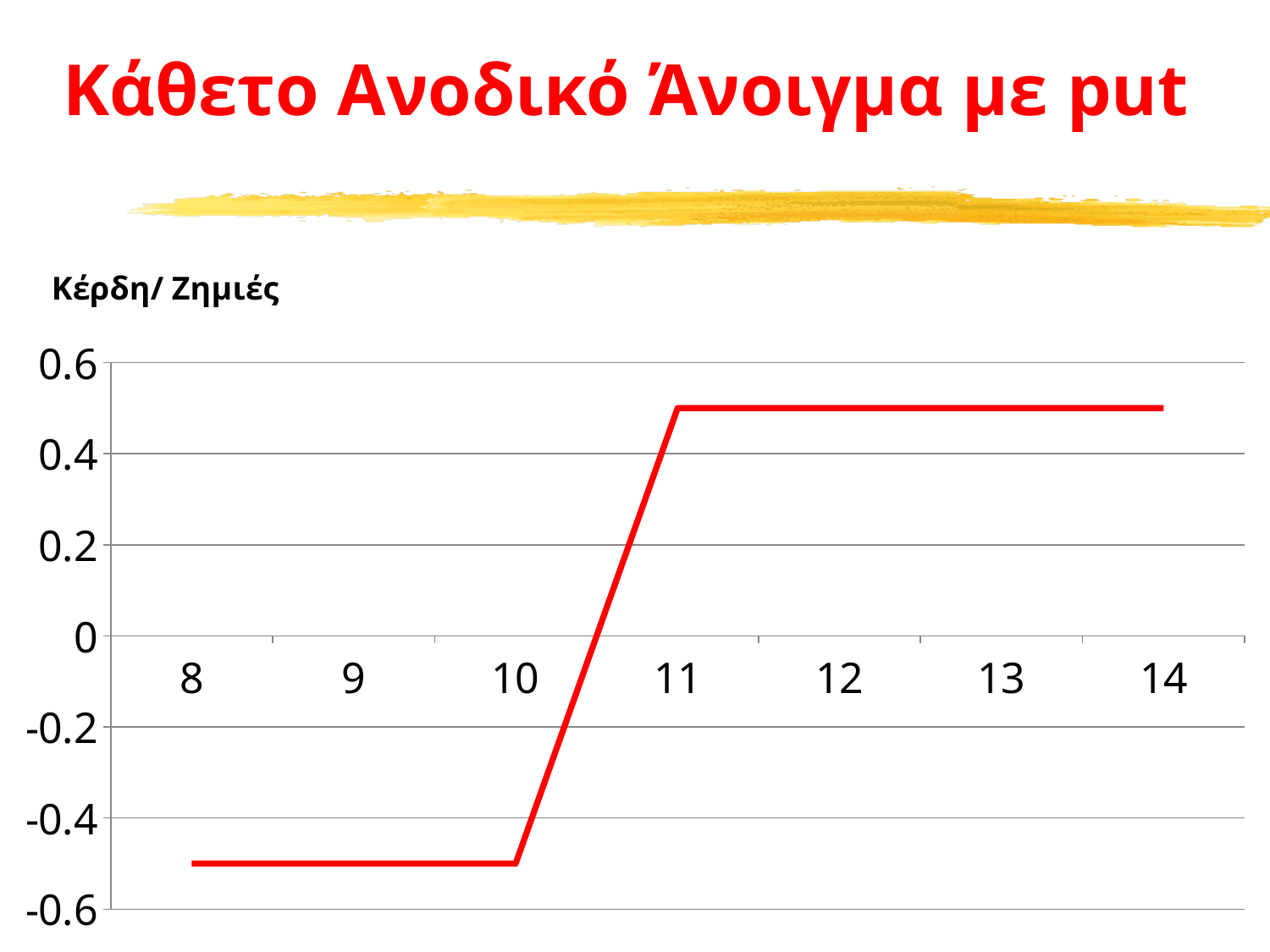
Is the value at x = 9 greater or less than 0? less Is the value at x = 10 greater or less than -0.4? less Does the line rise or fall as x increases from 10 to 11? rise How many tick labels are shown on the x axis? 7 Which is larger, the value at x = 9 or the value at x = 13? x = 13 What kind of chart is shown on the slide? line chart Is the value at x = 11 greater or less than 0? greater What label appears above the chart's vertical axis? Κέρδη/ Ζημιές What is the title of the slide? Κάθετο Ανοδικό Άνοιγμα με put